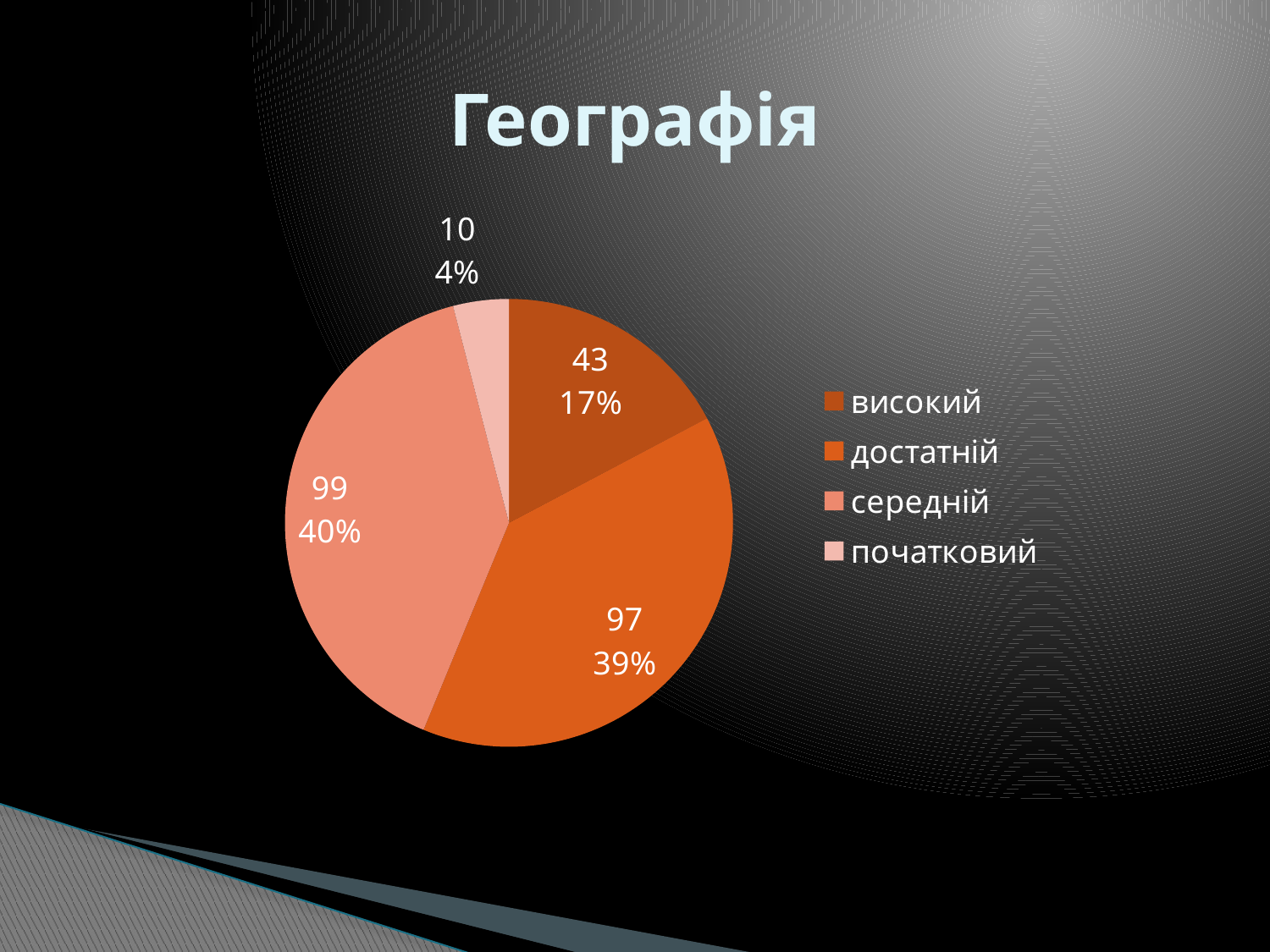
How many slices does the pie chart have? 4 What is the difference between the values for достатній and високий? 54 What kind of chart is shown on the slide? pie chart How many entries does the legend list? 4 Which is larger, the value for середній or the value for достатній? середній Which category has the smallest slice? початковий What is the value for середній? 99 What is the value for високий? 43 What is the value for достатній? 97 What is the value for початковий? 10 What share of the pie does високий represent? 17% What is the title of the chart? Географія